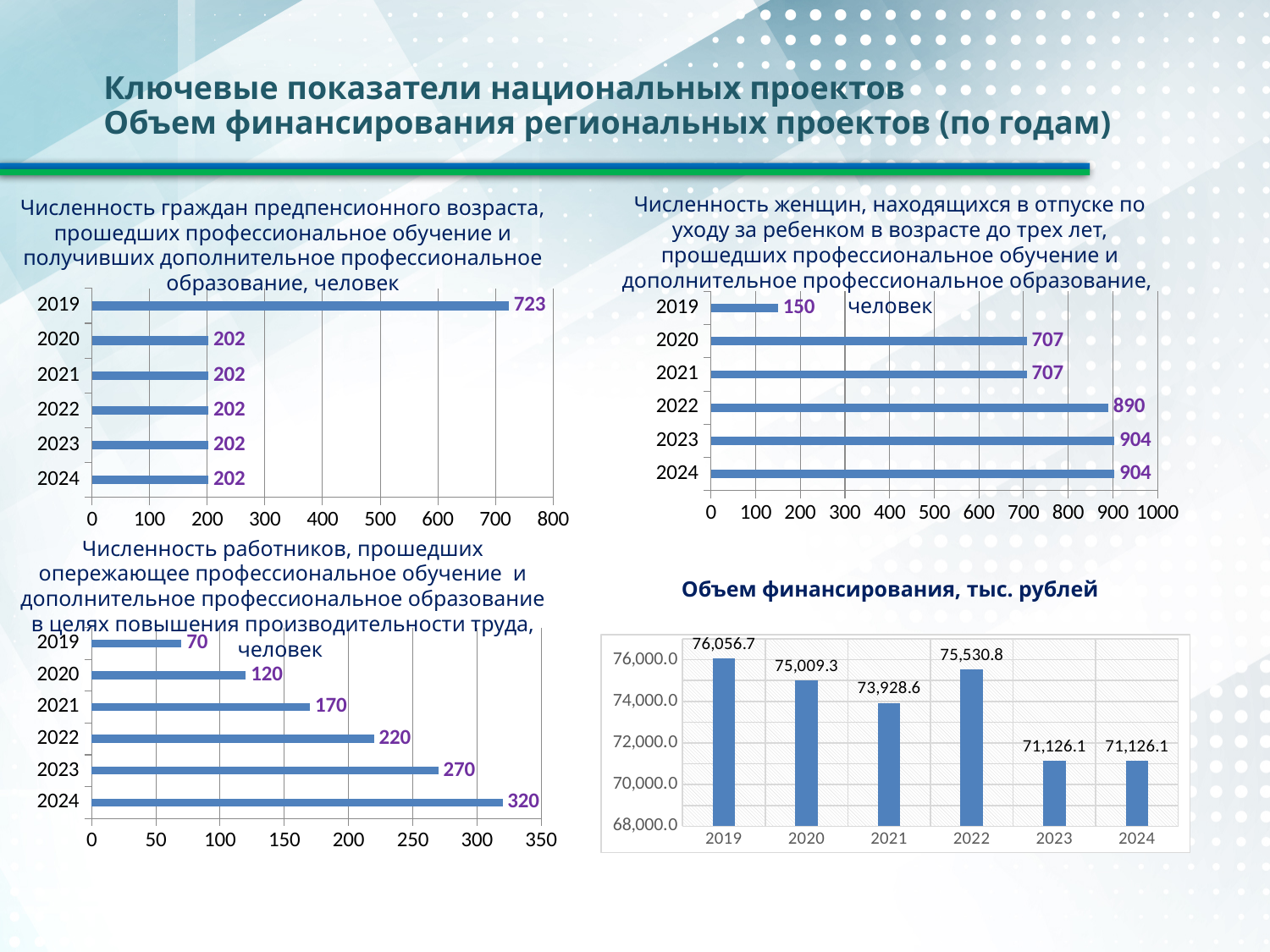
In the bottom-right chart (Объем финансирования, тыс. рублей), what is the value for 2021? 73,928.6 In the top-right chart (Численность женщин, находящихся в отпуске по уходу за ребенком), how many years are shown? 6 In the bottom-left chart (Численность работников, прошедших опережающее профессиональное обучение), do the values rise or fall from 2019 to 2024? rise What kind of chart is the bottom-right chart (Объем финансирования, тыс. рублей)? bar chart In the top-left chart (Численность граждан предпенсионного возраста), what is the value for 2019? 723 In the top-left chart (Численность граждан предпенсионного возраста), which year has the highest value? 2019 In the top-right chart (Численность женщин, находящихся в отпуске по уходу за ребенком), which year has the lowest value? 2019 In the bottom-right chart (Объем финансирования, тыс. рублей), which year has the highest value? 2019 In the top-left chart (Численность граждан предпенсионного возраста), what is the difference between the 2019 value and the 2020 value? 521 In the bottom-left chart (Численность работников, прошедших опережающее профессиональное обучение), what is the value for 2023? 270 In the top-right chart (Численность женщин, находящихся в отпуске по уходу за ребенком), what is the value for 2022? 890 In the bottom-left chart (Численность работников, прошедших опережающее профессиональное обучение), what is the difference between the 2024 value and the 2019 value? 250